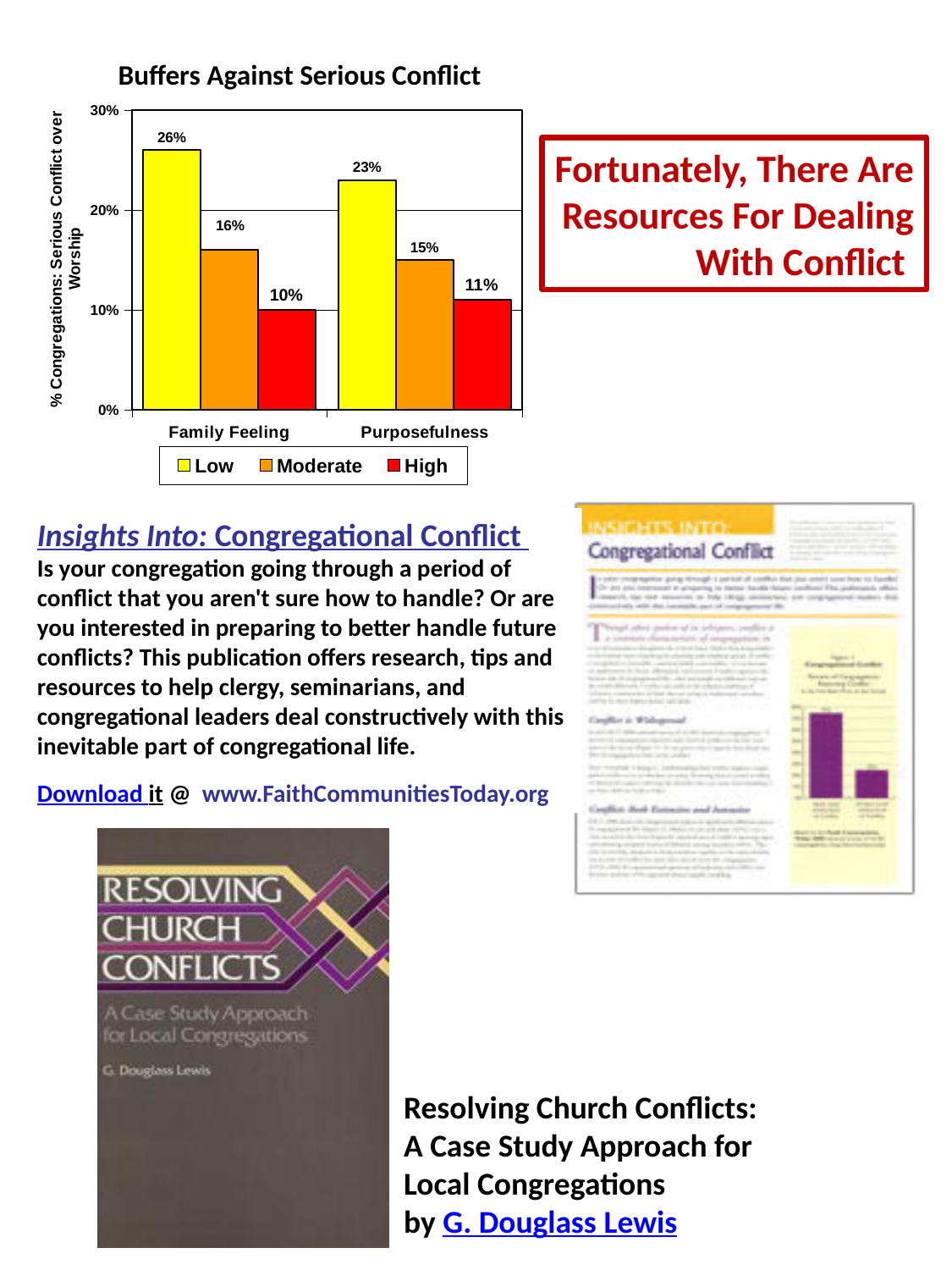
What is the value for Low under Family Feeling? 26% Which series has the lowest value under Family Feeling? High Which series has the highest value under Purposefulness? Low What is the value for High under Family Feeling? 10% What is the difference between the Low and High values under Family Feeling? 16% Which is larger: the Moderate value under Family Feeling or the Moderate value under Purposefulness? Family Feeling How many series does the legend list? 3 How many categories are shown on the x axis? 2 Is the value for Low under Purposefulness greater or less than 20%? greater What is the title of the chart? Buffers Against Serious Conflict What kind of chart is shown? bar chart What is the value for Moderate under Purposefulness? 15%